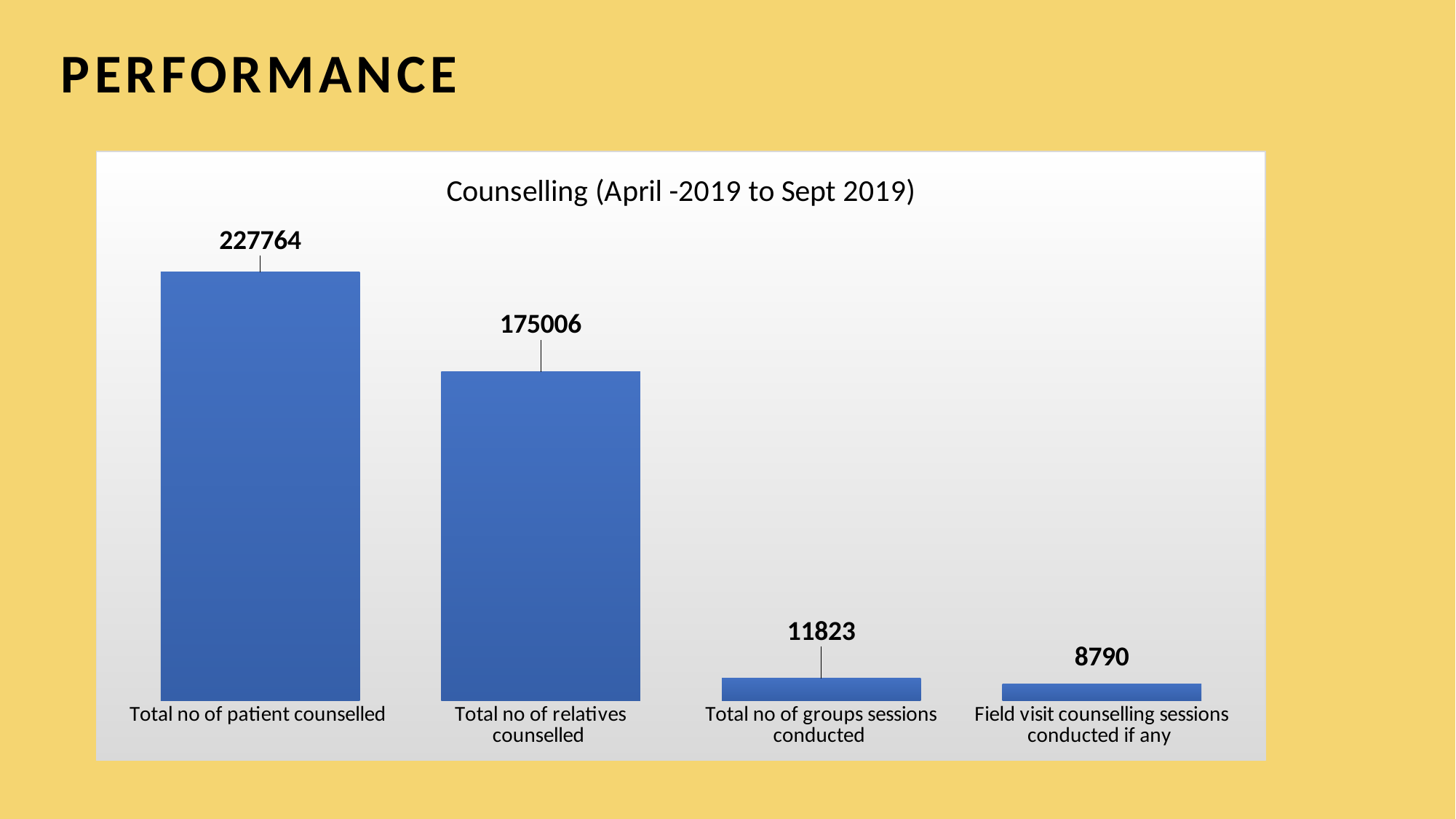
What is the value for Field visit counselling sessions conducted if any? 8790 What is the difference between Total no of groups sessions conducted and Field visit counselling sessions conducted if any? 3033 What is the value for Total no of groups sessions conducted? 11823 What is the difference between Total no of patient counselled and Total no of relatives counselled? 52758 What is the value for Total no of patient counselled? 227764 What is the value for Total no of relatives counselled? 175006 What is the title of the chart? Counselling (April -2019 to Sept 2019) Which category has the lowest value? Field visit counselling sessions conducted if any Which is larger: Total no of relatives counselled or Total no of groups sessions conducted? Total no of relatives counselled Which category has the highest value? Total no of patient counselled What kind of chart is shown on the slide? Bar chart How many categories are shown in the chart? 4